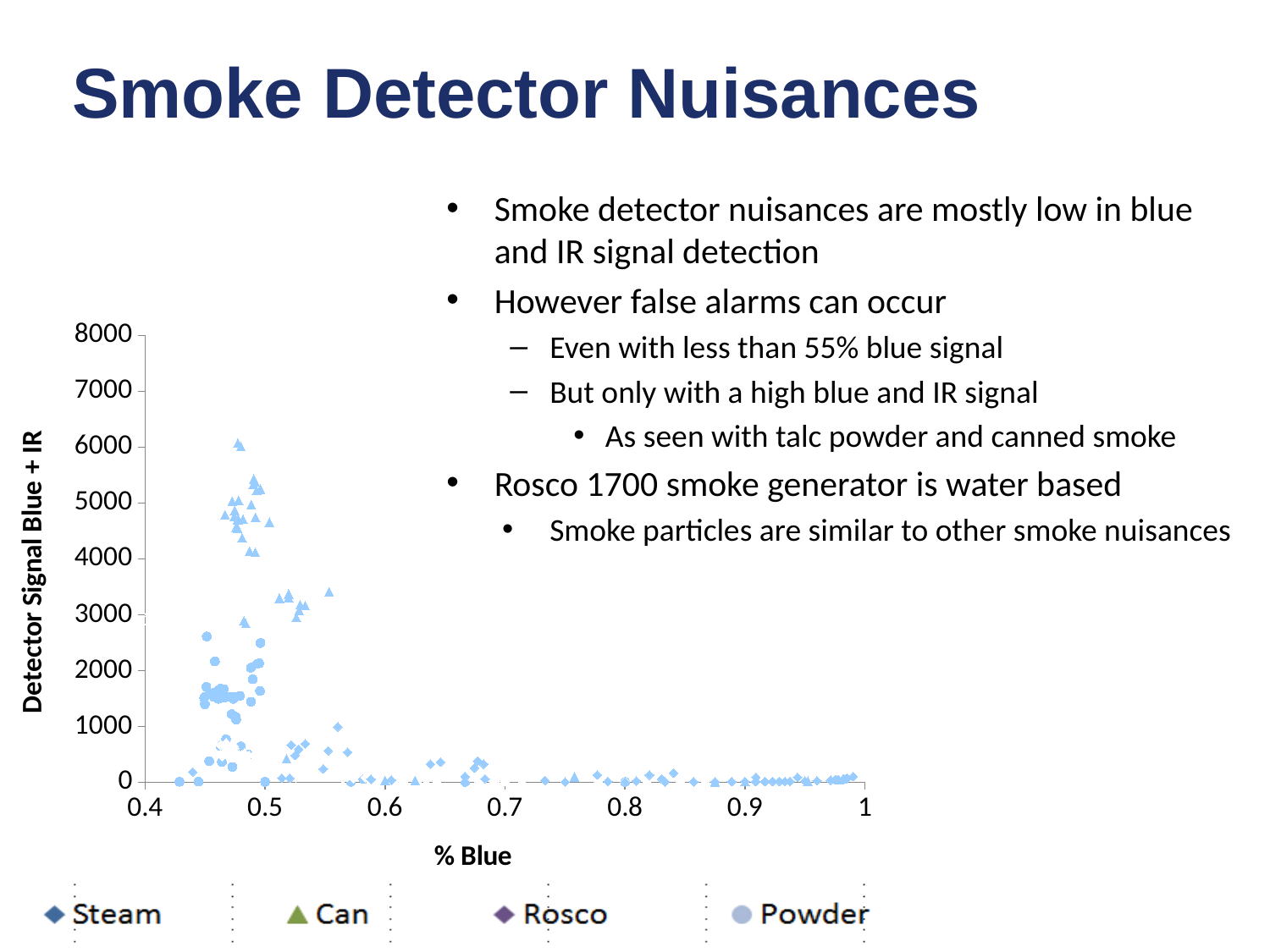
What kind of chart is shown on the slide? Scatter chart Is the highest Powder (circle) point greater or less than 3000 on the vertical axis? less How many series does the chart legend list? 4 Do the Detector Signal values generally rise or fall as % Blue increases from 0.5 to 1? fall Which series has a higher maximum Detector Signal value, Can or Powder? Can What is the lowest value shown on the chart's horizontal axis (% Blue)? 0.4 Is the highest Can (triangle) point greater or less than 5000 on the vertical axis? greater Which series reaches the highest Detector Signal Blue + IR value on the chart? Can What is the highest value shown on the chart's vertical axis? 8000 What are the series names listed in the chart legend? Steam, Can, Rosco, Powder What is the title of the chart's vertical axis? Detector Signal Blue + IR Are the points with % Blue above 0.7 greater or less than 1000 on the vertical axis? less